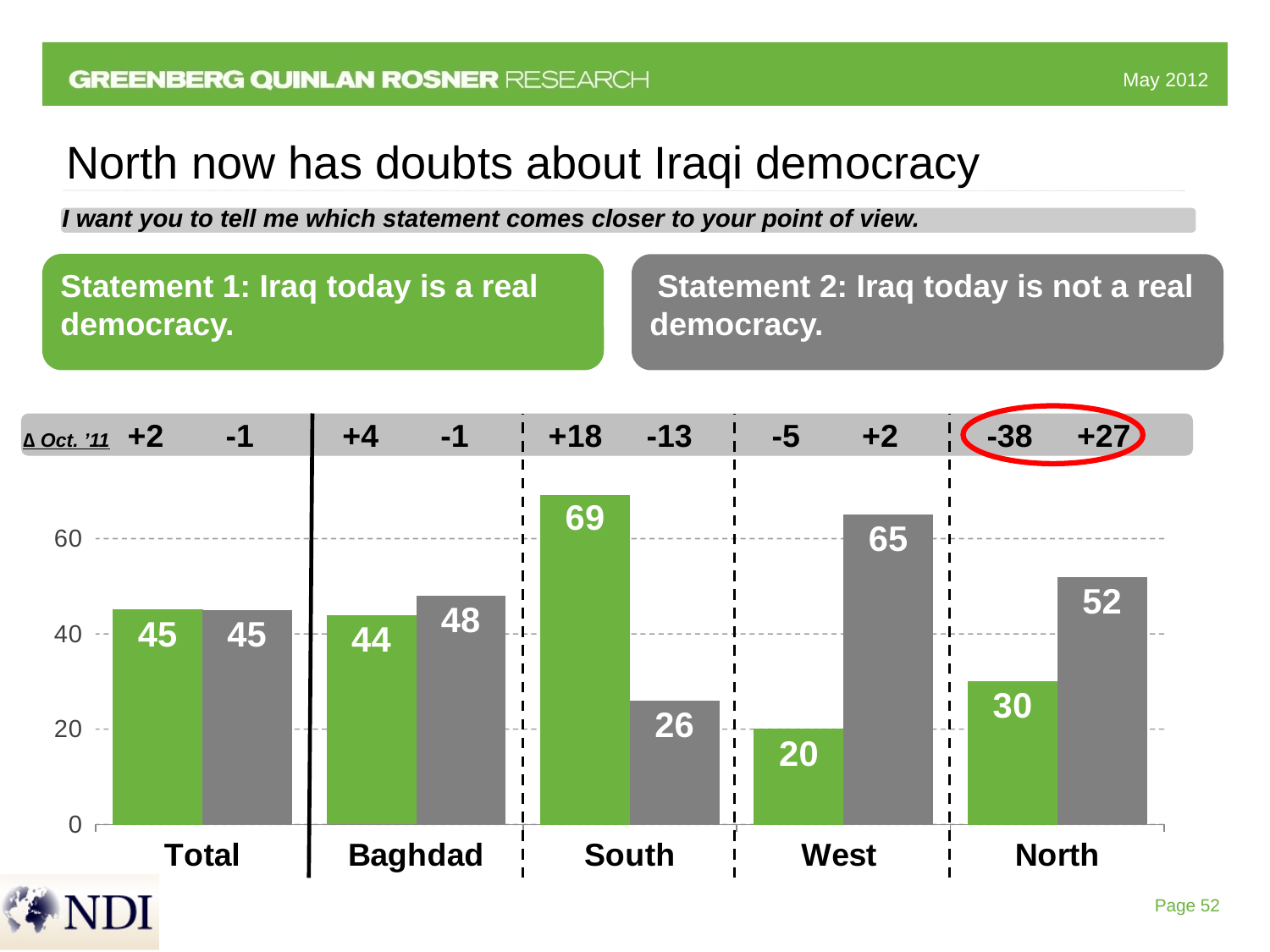
What percentage of respondents in the South say Iraq today is a real democracy (Statement 1)? 69 What is the value for Statement 2 (Iraq today is not a real democracy) in the West? 65 What colour are the bars for Statement 1 (Iraq today is a real democracy)? Green In Baghdad, which is larger: the value for Statement 1 or the value for Statement 2? Statement 2 What kind of chart is shown on the slide? Bar chart What is the change since Oct. '11 for Statement 1 in the North, as shown in the Δ row? -38 What is the value for Statement 1 (Iraq today is a real democracy) in the North? 30 How many categories are shown on the x axis of the chart? 5 What is the difference between Statement 2 and Statement 1 in the North? 22 How many series does the chart show? 2 Which region has the lowest value for Statement 1 (Iraq today is a real democracy)? West Which region has the highest value for Statement 1 (Iraq today is a real democracy)? South